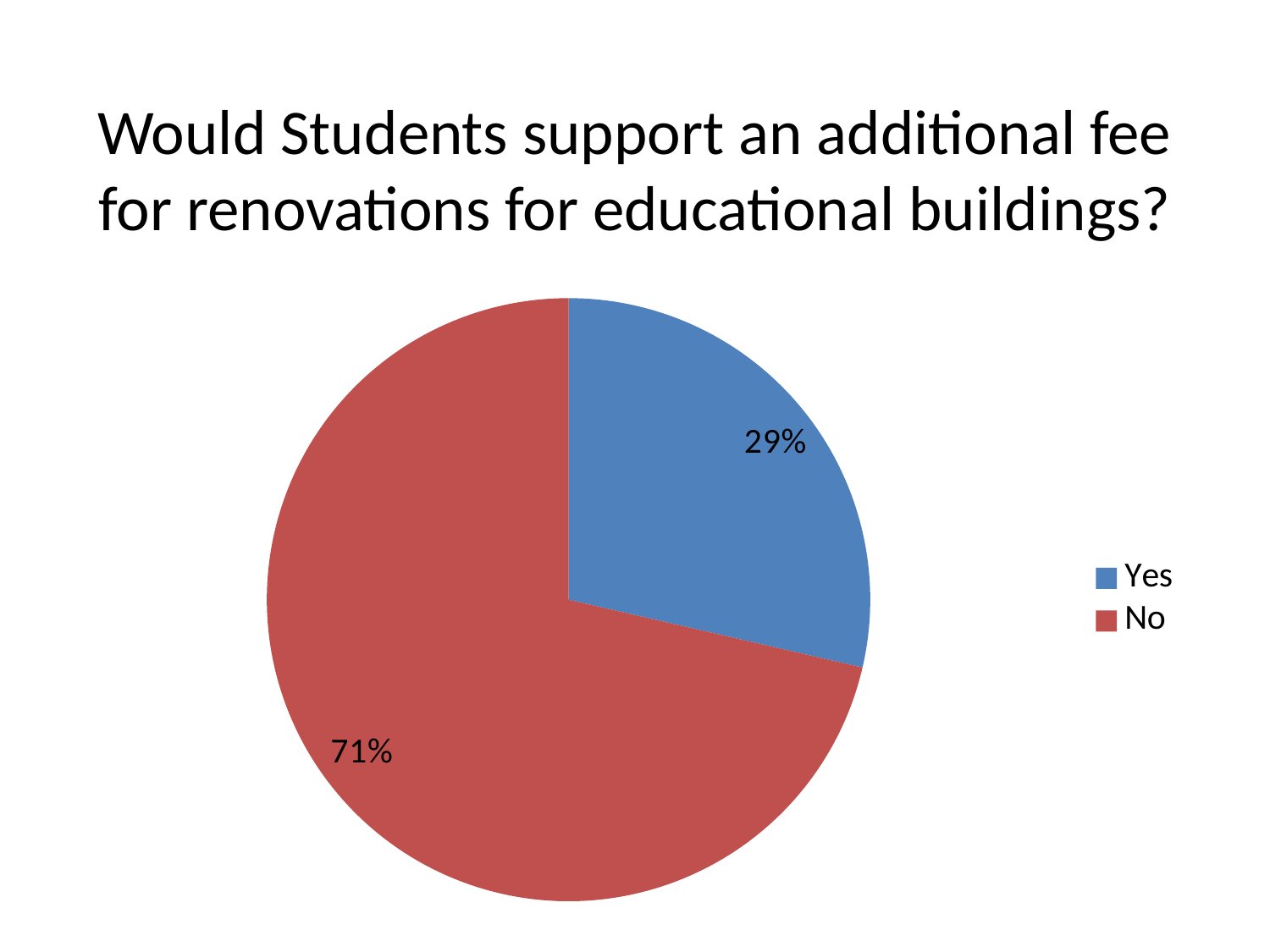
How many slices does the pie chart have? 2 Which is larger, the "Yes" slice or the "No" slice? No What kind of chart is shown on the slide? pie chart What is the difference in percentage points between the "No" slice and the "Yes" slice? 42 Which slice is the largest? No What is the title of the chart? Would Students support an additional fee for renovations for educational buildings? How many entries does the legend list? 2 What share of the pie is labelled "No"? 71% What colour is the "No" slice? red What share of the pie is labelled "Yes"? 29% Which slice is the smallest? Yes